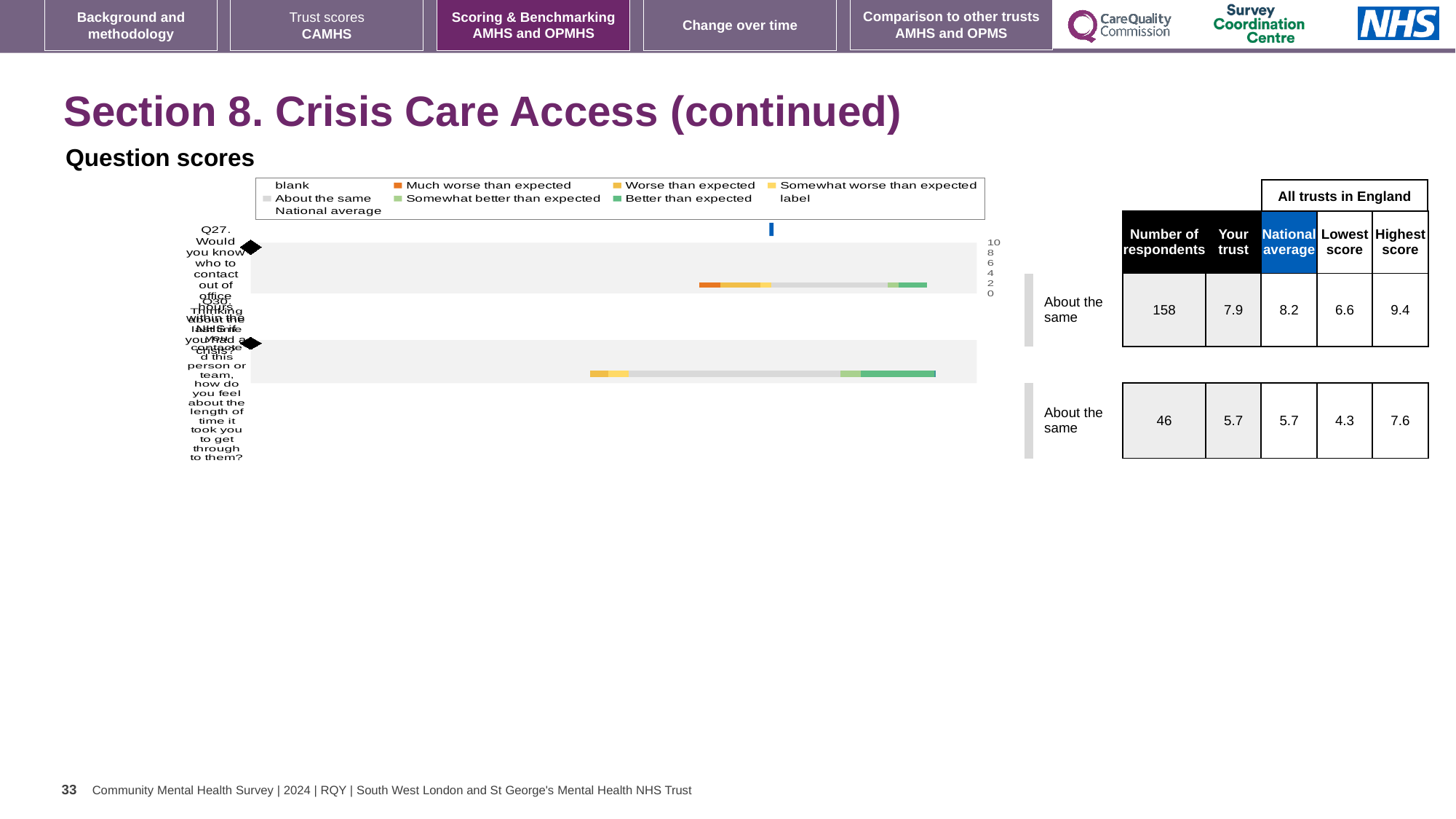
What is the national average score for Q27? 8.2 Which question has the higher 'Your trust' score, Q27 or Q30? Q27 What kind of chart is used to show the question scores? bar chart What is the difference between the highest and lowest scores for Q30? 3.3 For Q27, which is larger: the trust's score or the national average? national average What colour represents 'Much worse than expected' in the chart legend? orange What benchmark category is shown for Q27? About the same How many questions are plotted in the question scores chart? 2 How many respondents answered Q30? 46 What is the difference between the highest and lowest scores for Q27? 2.8 What is the 'Your trust' score for Q27 (would you know who to contact out of office hours)? 7.9 What is the 'Your trust' score for Q30? 5.7